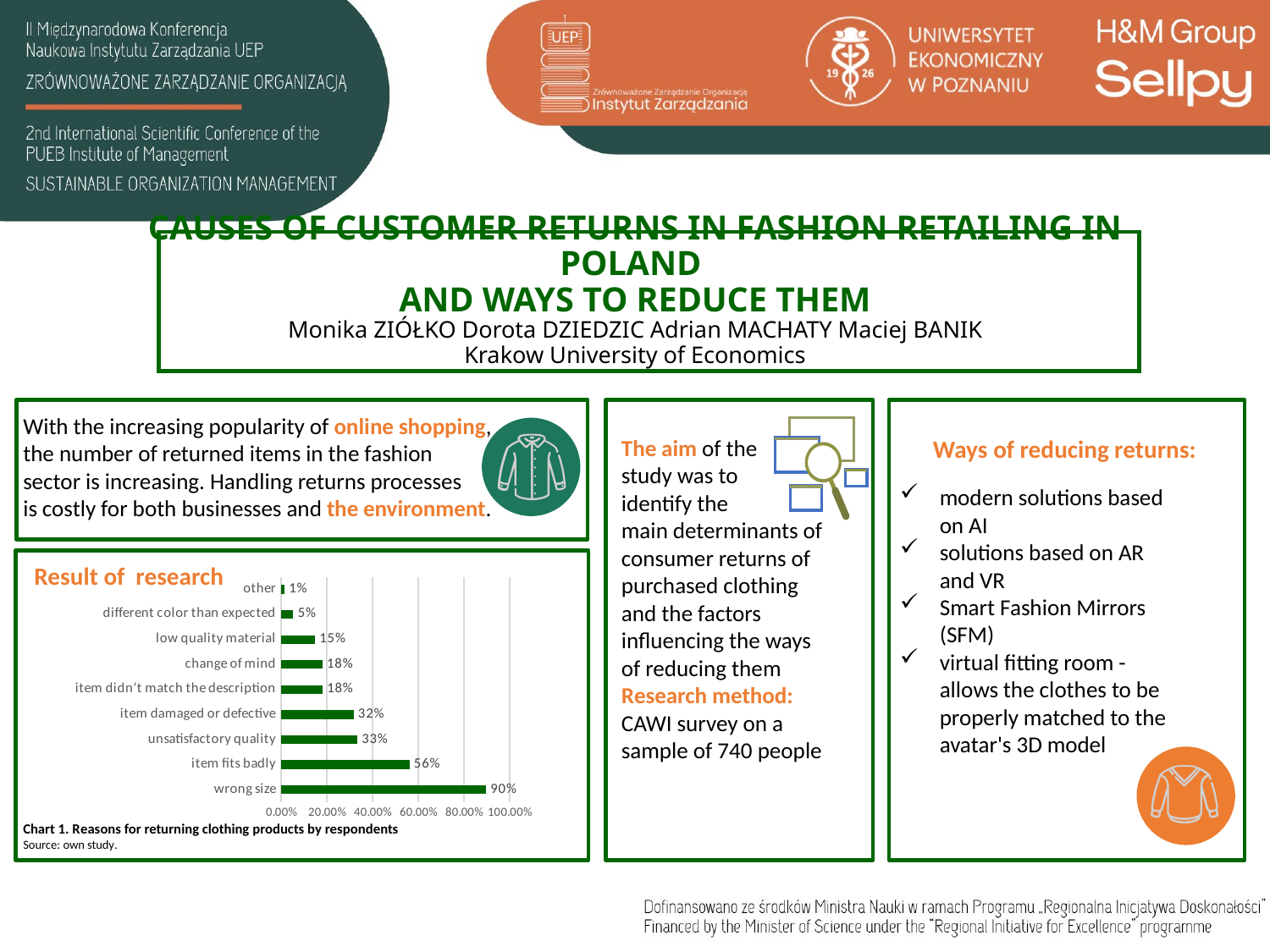
What is the value shown for "item fits badly"? 56% What percentage is shown for "unsatisfactory quality"? 33% What is the difference between the values for "wrong size" and "item fits badly"? 34% What is the caption of the chart on the slide? Chart 1. Reasons for returning clothing products by respondents Which is larger: the value for "low quality material" or the value for "change of mind"? change of mind Which category has the lowest value in the chart? other What percentage of respondents gave "wrong size" as a reason for returning clothing products? 90% What value is shown for "different color than expected"? 5% Is the value for "item damaged or defective" greater or less than 40.00%? less Which reason for returning clothing has the highest percentage? wrong size How many reasons for returning clothing products are shown in the chart? 9 What type of chart is used to show the reasons for returning clothing products? bar chart